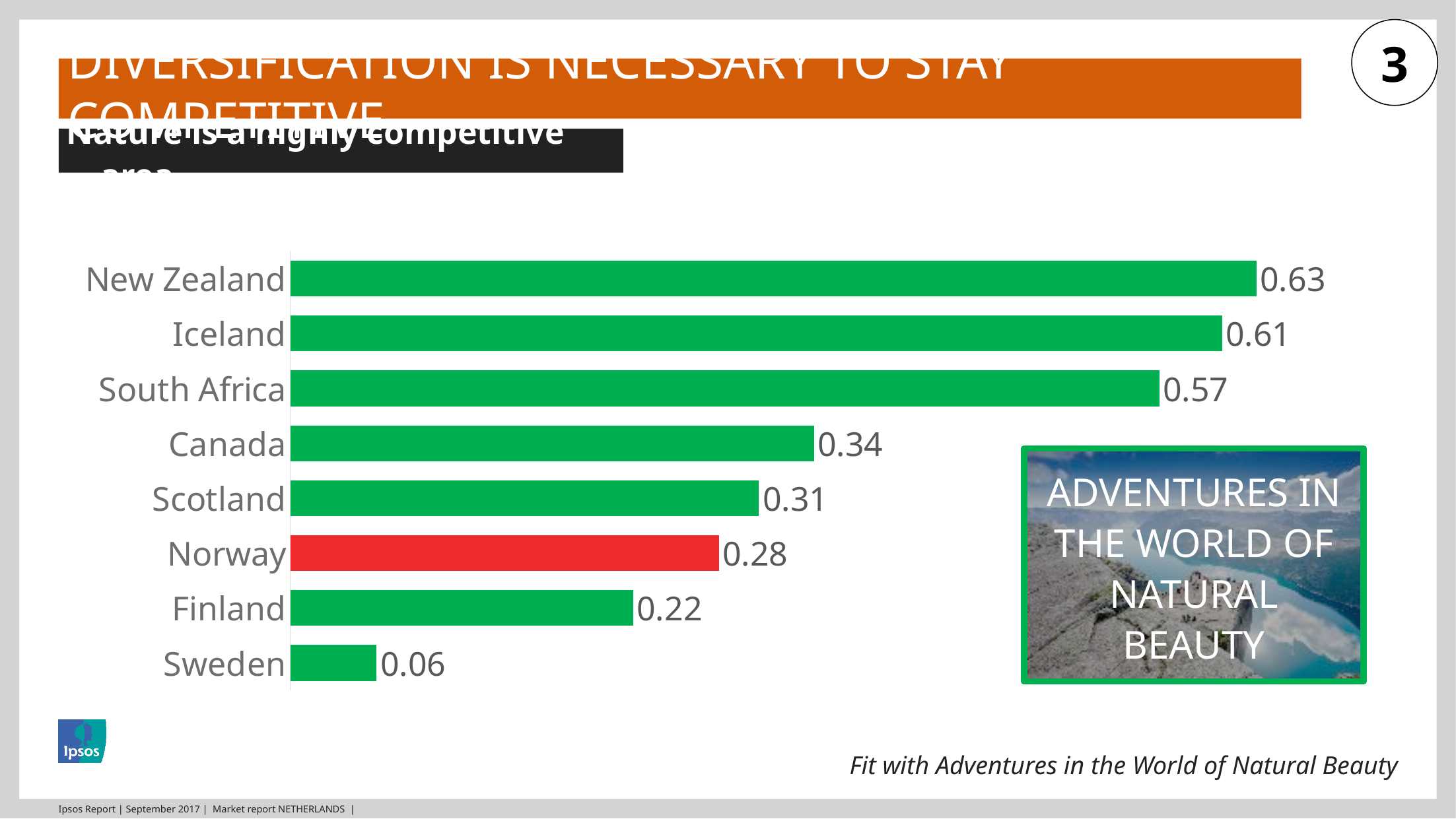
What is the value for South Africa? 0.57 How many countries are shown in the chart? 8 Which country's bar is coloured red rather than green? Norway Which country has the highest value? New Zealand What kind of chart is shown on the slide? Bar chart Which has a larger value, Scotland or Norway? Scotland What is the difference between the values for New Zealand and Iceland? 0.02 What is the difference between the values for Canada and Finland? 0.12 What is the value for New Zealand? 0.63 Which country has the lowest value? Sweden What is the value for Norway? 0.28 What is the value for Sweden? 0.06